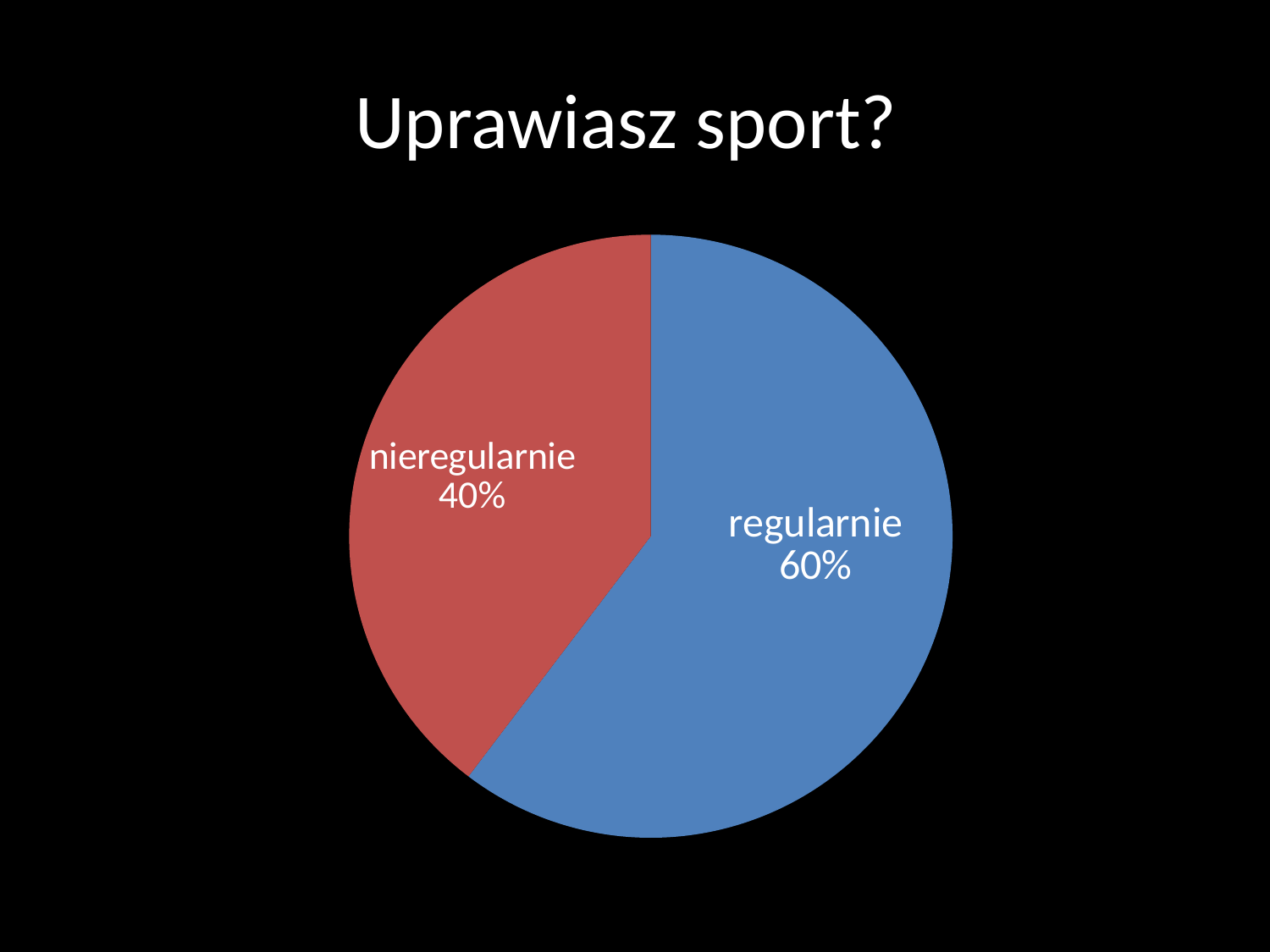
Which slice of the pie is the smallest? nieregularnie What is the title of the chart? Uprawiasz sport? What share of the pie is labelled "regularnie"? 60% What is the difference in percentage points between the "regularnie" and "nieregularnie" slices? 20 percentage points Is the share for "regularnie" greater or less than 50%? greater How many slices does the pie chart have? 2 Which slice of the pie is the largest? regularnie What colour is the "nieregularnie" slice? red Which is larger, the "regularnie" slice or the "nieregularnie" slice? regularnie What kind of chart is shown on the slide? pie chart What share of the pie is labelled "nieregularnie"? 40%